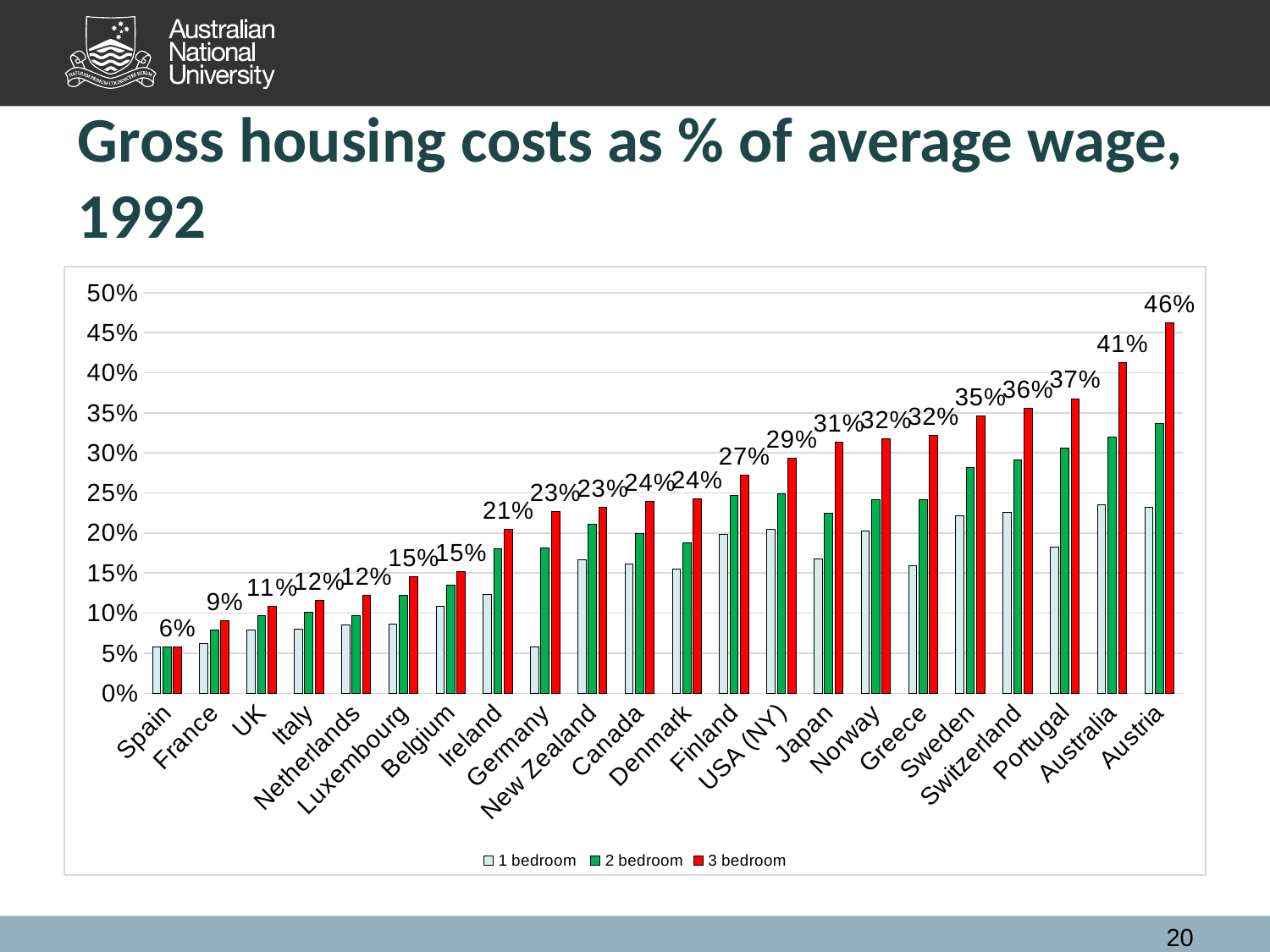
How many series does the legend list? 3 Which has the larger 3 bedroom value, Japan or Finland? Japan Is the 1 bedroom value for Australia greater or less than 20%? greater What is the 3 bedroom value for Ireland? 21% What is the difference between the 3 bedroom values for Australia and Portugal? 4% Which country has the lowest 3 bedroom value? Spain Do the 3 bedroom values rise or fall from Spain to Austria along the x axis? Rise Which country has the highest 3 bedroom value? Austria What is the 3 bedroom value for Austria? 46% What kind of chart is shown? Bar chart How many countries are shown on the x axis? 22 Is the 2 bedroom value for Germany greater or less than 20%? less